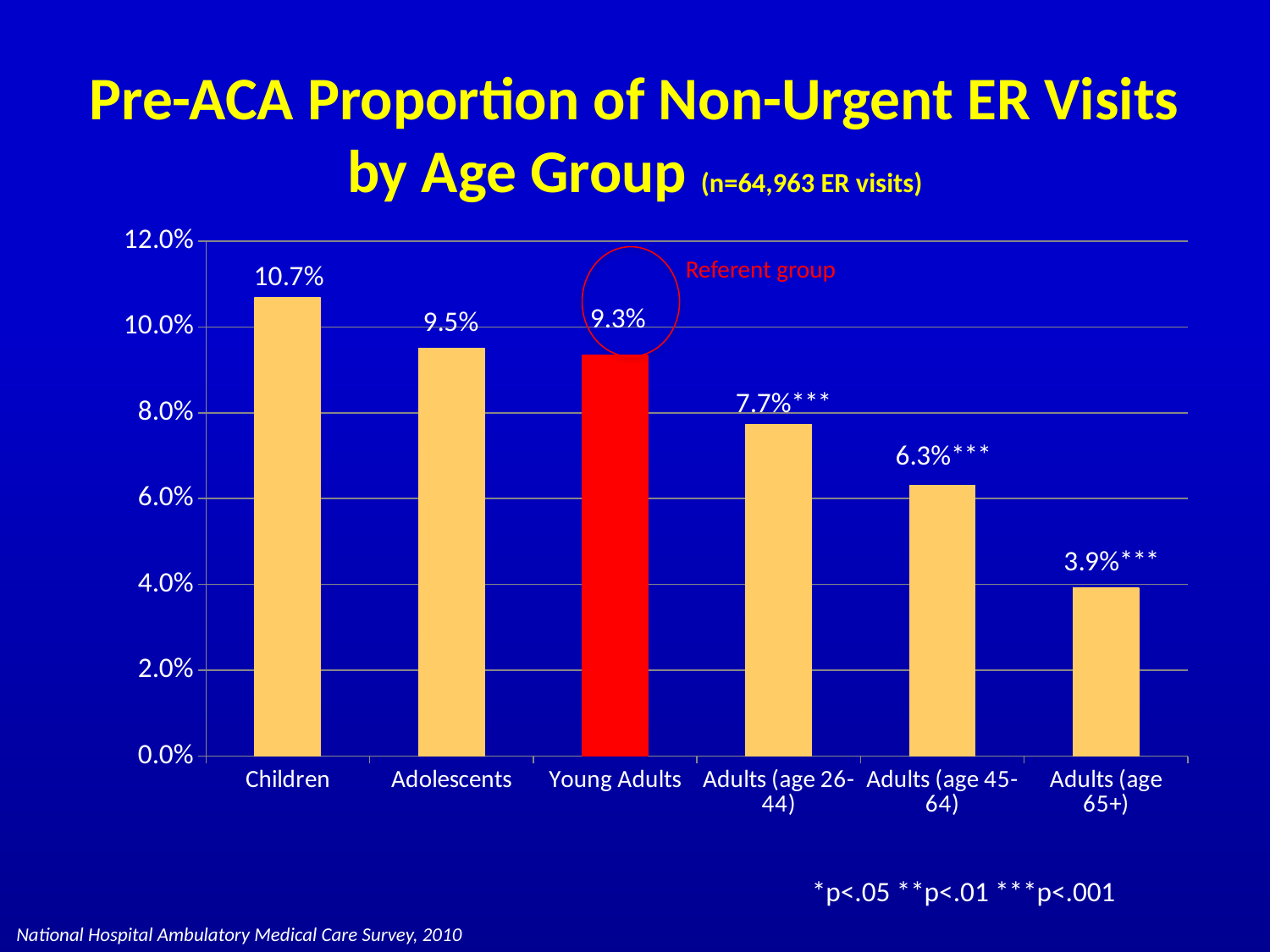
What is the proportion of non-urgent ER visits for Children? 10.7% What is the proportion of non-urgent ER visits for Young Adults? 9.3% What kind of chart is shown on the slide? Bar chart Which has a higher proportion of non-urgent ER visits, Adolescents or Adults (age 26-44)? Adolescents Do the values rise or fall moving from Children to Adults (age 65+) along the x axis? Fall What is the difference between the proportions for Children and Adults (age 65+)? 6.8% Which age group has the lowest proportion of non-urgent ER visits? Adults (age 65+) How many age groups are shown in the chart? 6 Which age group is marked as the referent group in the chart? Young Adults What is the proportion of non-urgent ER visits for Adults (age 65+)? 3.9% What is the difference between the proportions for Adults (age 26-44) and Adults (age 45-64)? 1.4% Which age group has the highest proportion of non-urgent ER visits? Children